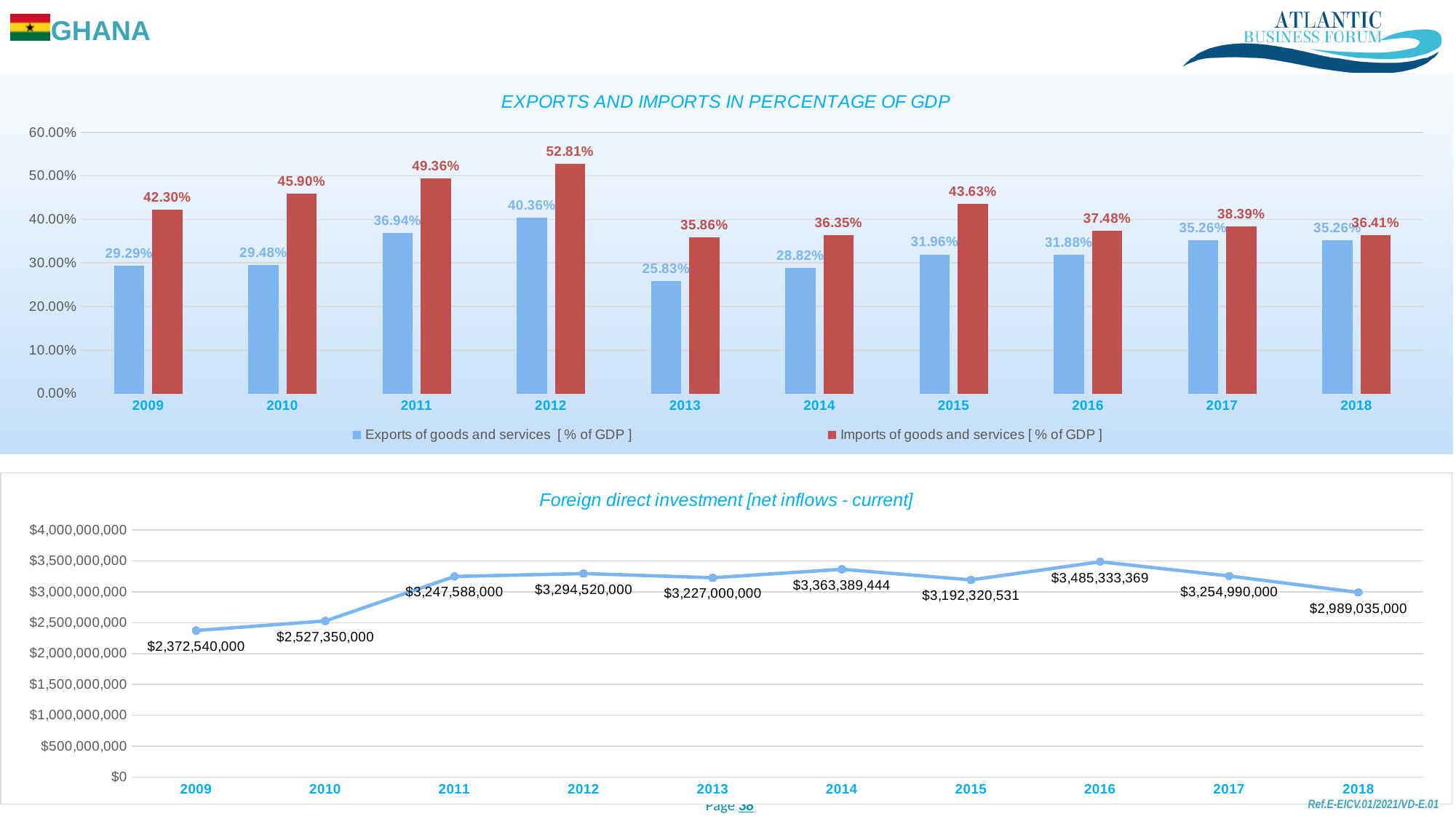
What kind of chart is the 'Exports and Imports in Percentage of GDP' chart? Bar chart How many years are plotted in the 'Foreign direct investment [net inflows - current]' chart? 10 In the 'Foreign direct investment [net inflows - current]' chart, which year has the lowest value? 2009 In the 'Foreign direct investment [net inflows - current]' chart, is the value for 2017 larger than the value for 2018? Yes In the 'Exports and Imports in Percentage of GDP' chart, which year has the lowest Exports of goods and services value? 2013 In the 'Foreign direct investment [net inflows - current]' chart, what is the value for 2016? $3,485,333,369 What kind of chart is the 'Foreign direct investment [net inflows - current]' chart? Line chart In the 'Exports and Imports in Percentage of GDP' chart, what is the difference between Imports and Exports in 2012? 12.45% In the 'Exports and Imports in Percentage of GDP' chart, what is the value of Exports of goods and services in 2012? 40.36% In the 'Exports and Imports in Percentage of GDP' chart, how many series does the legend list? 2 In the 'Exports and Imports in Percentage of GDP' chart, what is the value of Imports of goods and services in 2015? 43.63% In the 'Exports and Imports in Percentage of GDP' chart, which year has the highest Imports of goods and services value? 2012